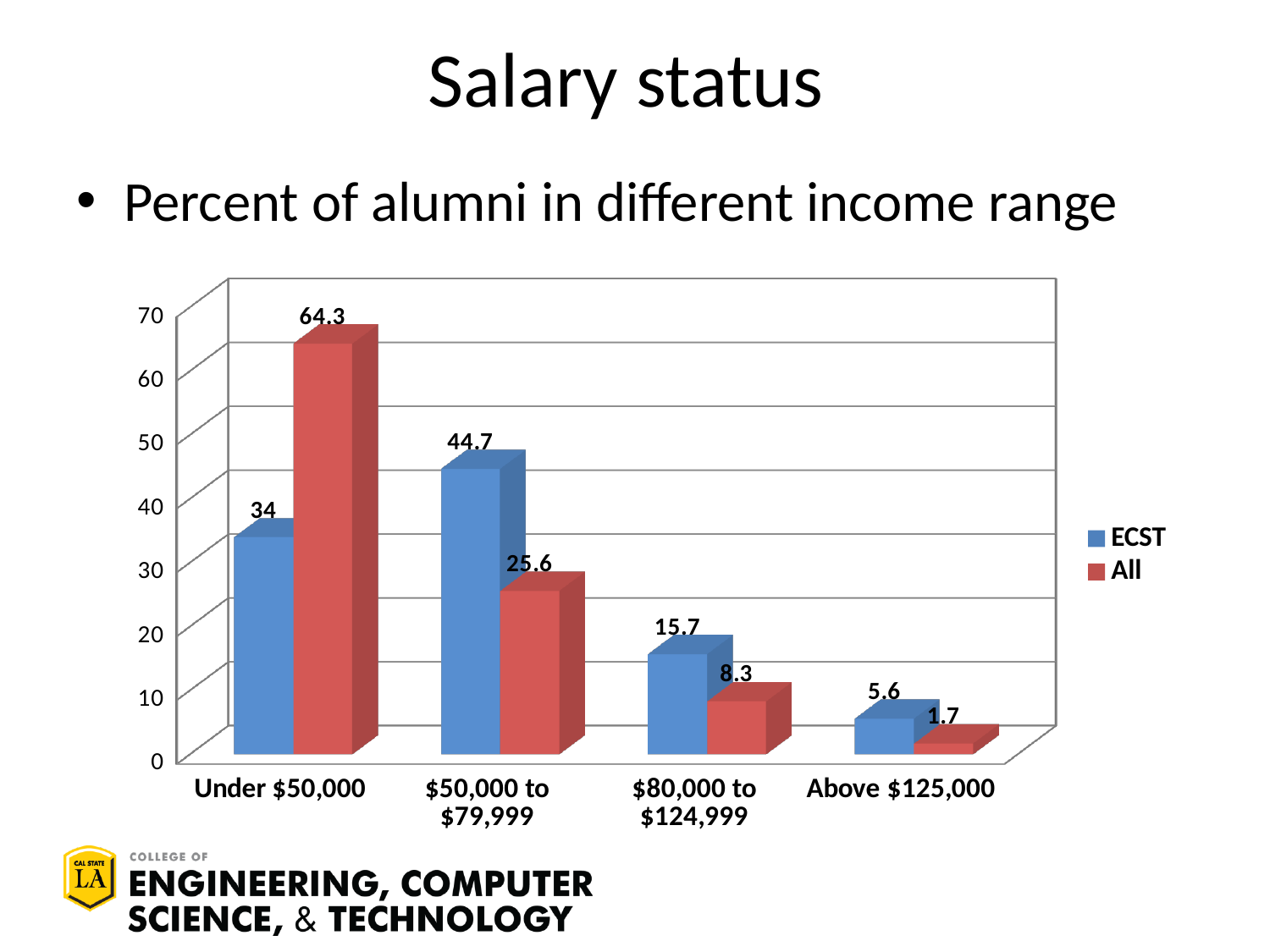
Which income range has the lowest ECST value? Above $125,000 Which income range has the highest All value? Under $50,000 How many series does the legend list? 2 What is the difference between the All and ECST values for the Under $50,000 range? 30.3 What is the ECST value for the Under $50,000 income range? 34 What colour are the bars for the All series? Red What kind of chart is shown on the slide? Bar chart For the $80,000 to $124,999 range, which series has the larger value, ECST or All? ECST How many income ranges are shown on the x axis? 4 What is the All value for the $50,000 to $79,999 income range? 25.6 Do the All values rise or fall from Under $50,000 to Above $125,000? Fall What is the ECST value for the Above $125,000 income range? 5.6